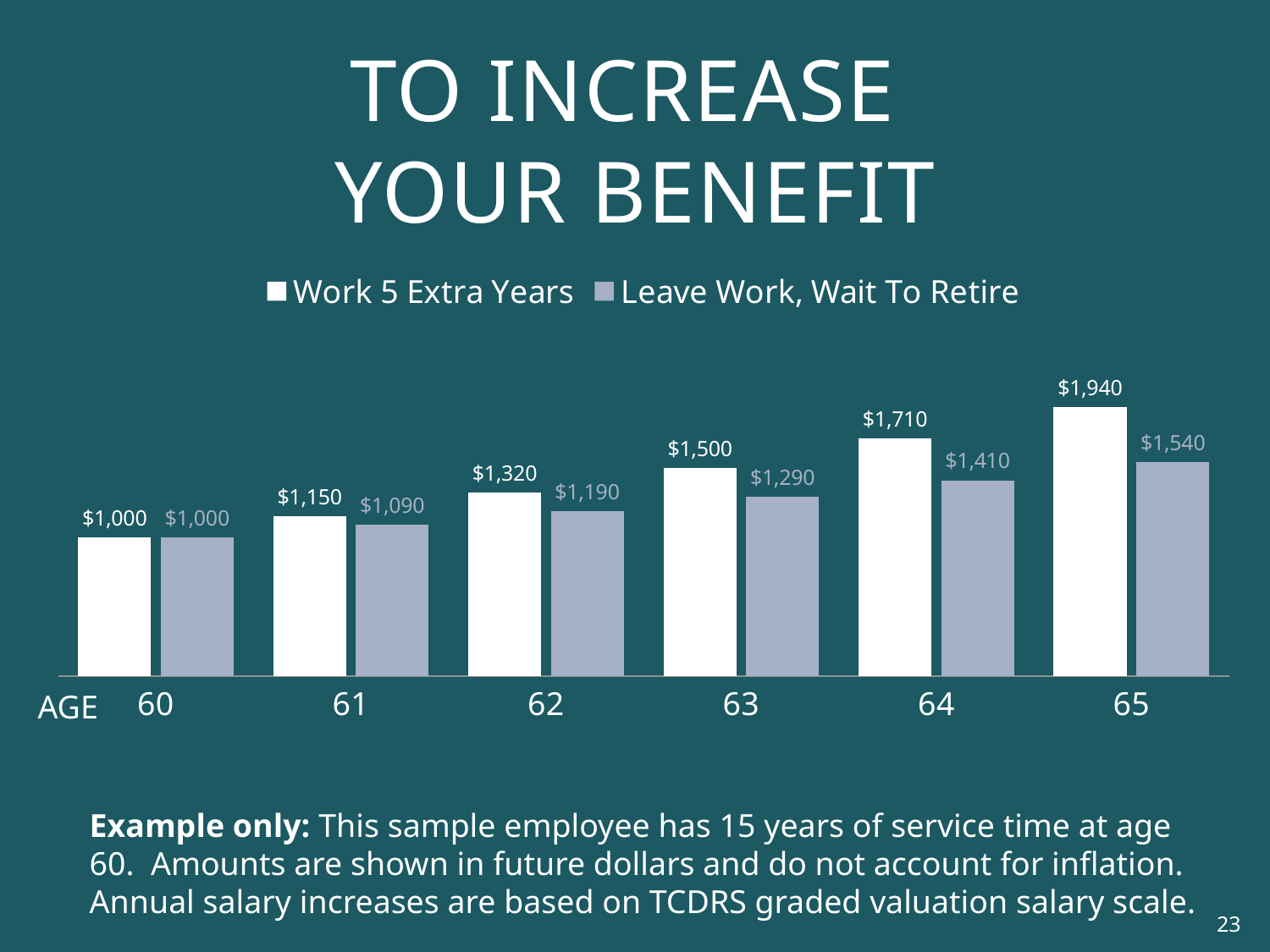
What kind of chart is shown on the slide? Bar chart Which is larger at age 64: Work 5 Extra Years or Leave Work, Wait To Retire? Work 5 Extra Years How many age categories are shown on the x axis? 6 What is the difference between the Work 5 Extra Years values at age 62 and age 61? $170 What is the value for Work 5 Extra Years at age 63? $1,500 At which age is the Work 5 Extra Years value highest? 65 What is the difference between Work 5 Extra Years and Leave Work, Wait To Retire at age 65? $400 What is the value for Leave Work, Wait To Retire at age 61? $1,090 At which age is the Leave Work, Wait To Retire value lowest? 60 What is the value for Leave Work, Wait To Retire at age 64? $1,410 Do the Leave Work, Wait To Retire values rise or fall as age increases from 60 to 65? Rise How many series does the legend list? 2